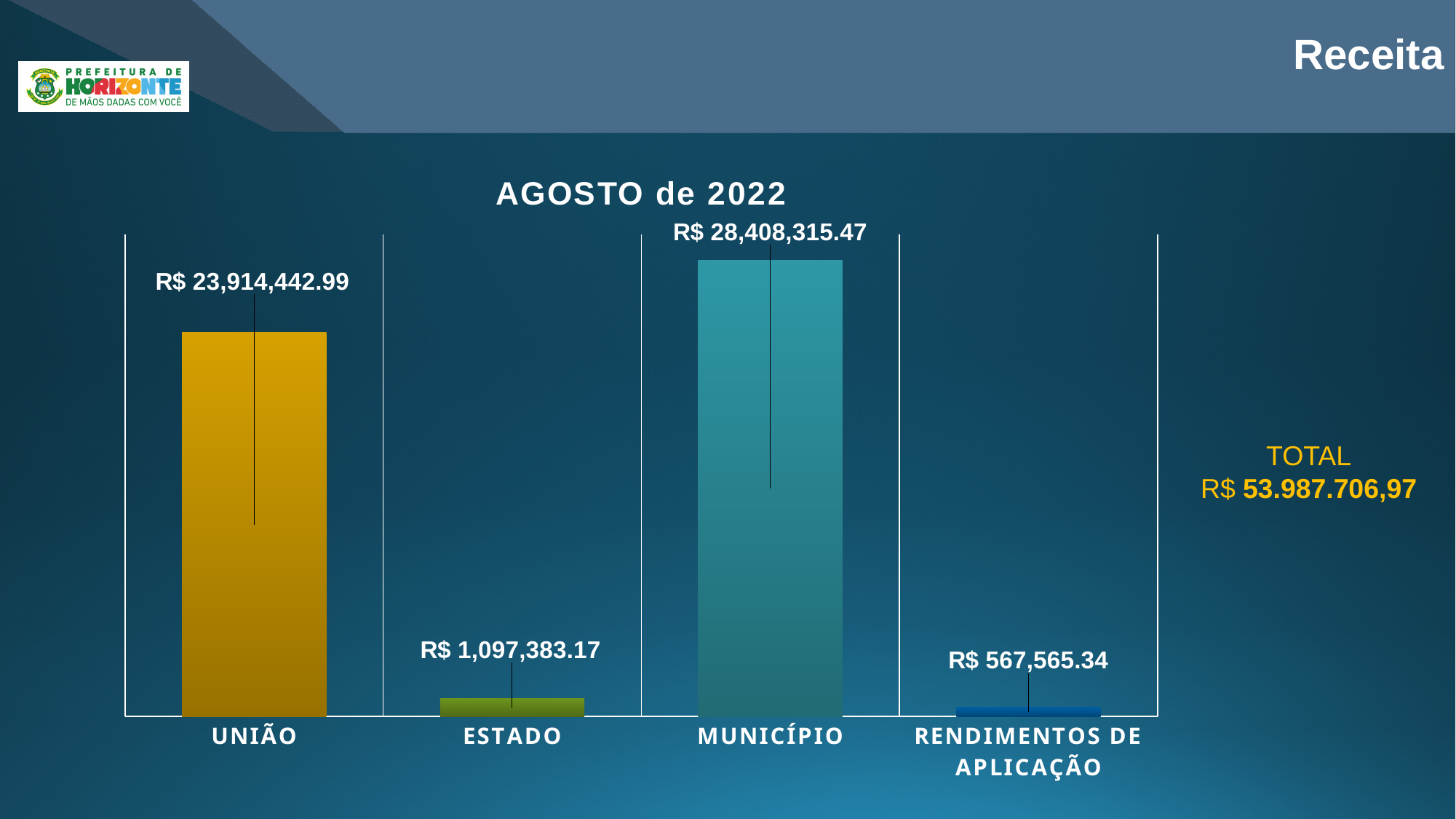
Which category has the highest value? MUNICÍPIO What is the difference between the values for MUNICÍPIO and UNIÃO? R$ 4,493,872.48 Which is larger, the value for UNIÃO or the value for ESTADO? UNIÃO How many categories are shown in the chart? 4 What is the value for ESTADO? R$ 1,097,383.17 What is the value for MUNICÍPIO? R$ 28,408,315.47 What is the value for UNIÃO? R$ 23,914,442.99 What is the title of the chart? AGOSTO de 2022 What kind of chart is shown on the slide? Bar chart What is the difference between the values for ESTADO and RENDIMENTOS DE APLICAÇÃO? R$ 529,817.83 What is the value for RENDIMENTOS DE APLICAÇÃO? R$ 567,565.34 Which category has the lowest value? RENDIMENTOS DE APLICAÇÃO